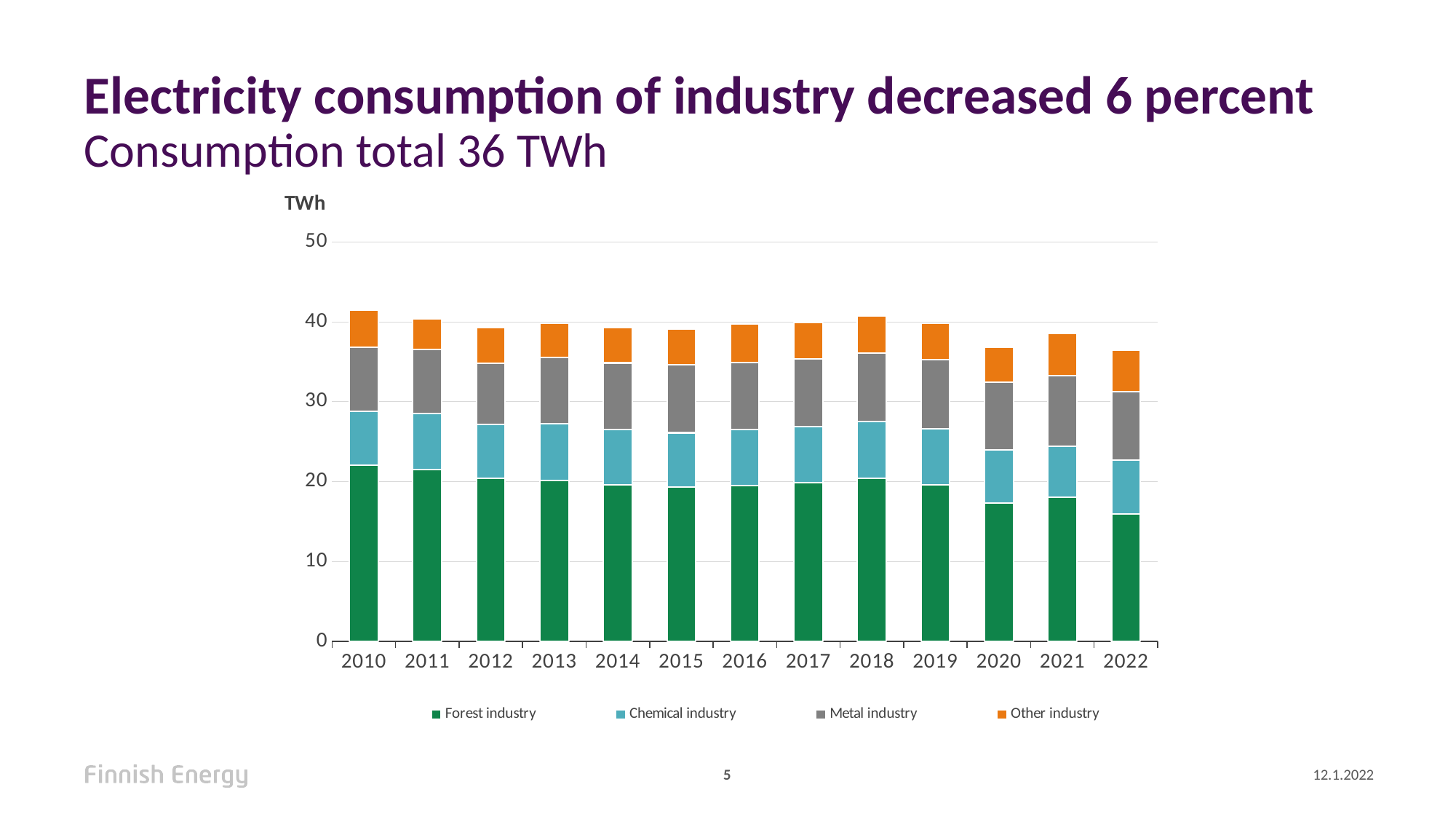
What unit is shown on the vertical axis of the chart? TWh Does the Forest industry value rise or fall from 2010 to 2013? fall Is the Forest industry value for 2010 greater or less than 20? greater How many series does the chart legend list? 4 Is the Forest industry value for 2022 greater or less than 20? less In which year is the Forest industry value lowest? 2022 How many years are shown on the x axis of the chart? 13 What kind of chart is shown on the slide? Stacked bar chart Is the total height of the stacked bar for 2022 greater or less than 40? less Which year has the larger total stacked bar, 2010 or 2022? 2010 Which series is shown at the bottom of each stacked bar? Forest industry